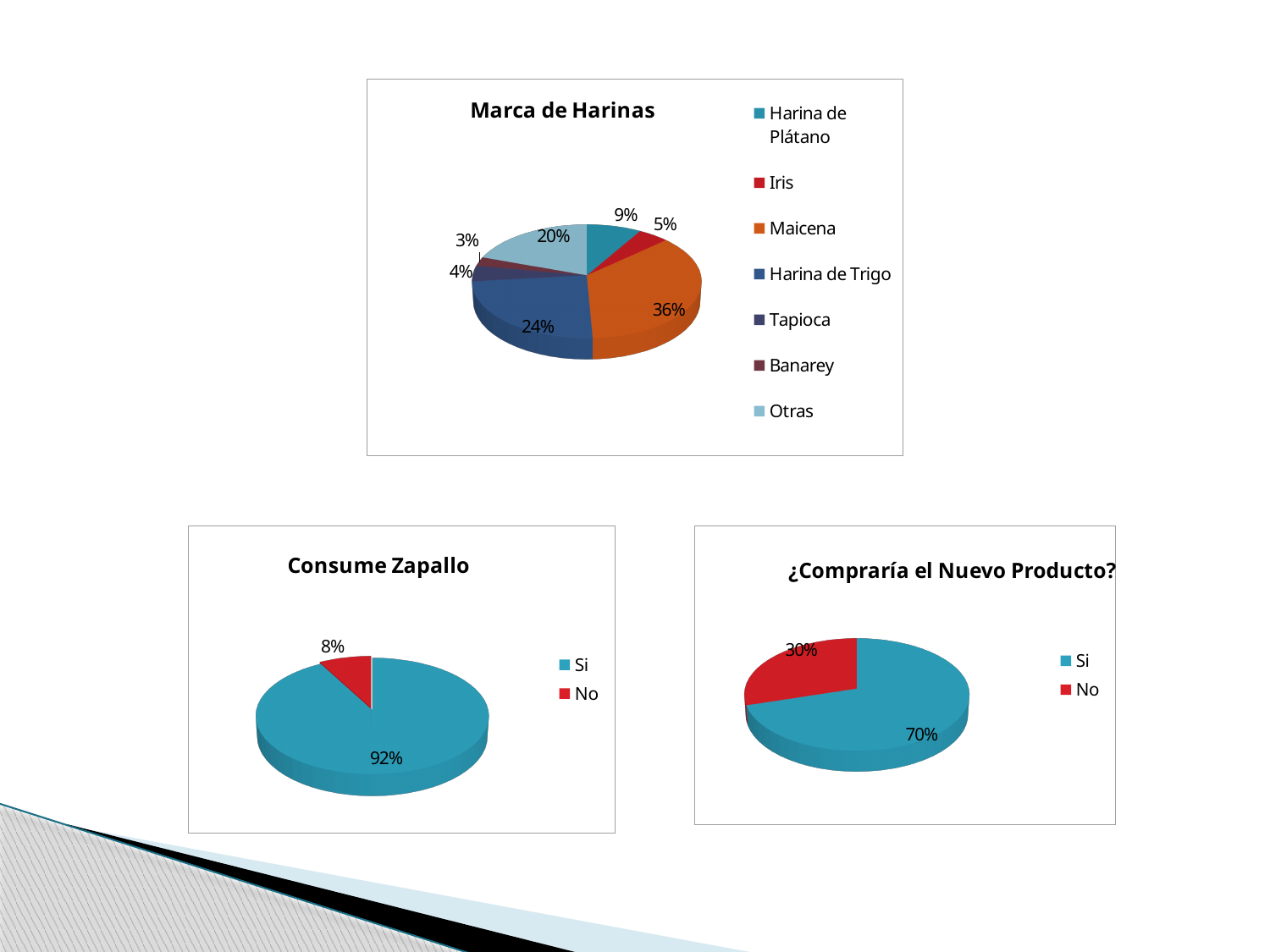
What kind of chart is 'Consume Zapallo'? Pie chart How many pie charts are shown on the slide? 3 In the 'Consume Zapallo' chart, what share answered Si? 92% In the 'Marca de Harinas' chart, what share does Harina de Trigo have? 24% In the 'Marca de Harinas' chart, which brand has the smallest share? Banarey In the 'Marca de Harinas' chart, how many categories does the legend list? 7 In the '¿Compraría el Nuevo Producto?' chart, what share answered No? 30% In the 'Marca de Harinas' chart, which brand has the largest share? Maicena In the '¿Compraría el Nuevo Producto?' chart, what is the difference between the Si and No shares? 40% In the 'Marca de Harinas' chart, what share does Maicena have? 36% In the 'Marca de Harinas' chart, what is the difference between the shares of Maicena and Harina de Trigo? 12% In the 'Marca de Harinas' chart, which is larger, the share of Otras or the share of Harina de Plátano? Otras